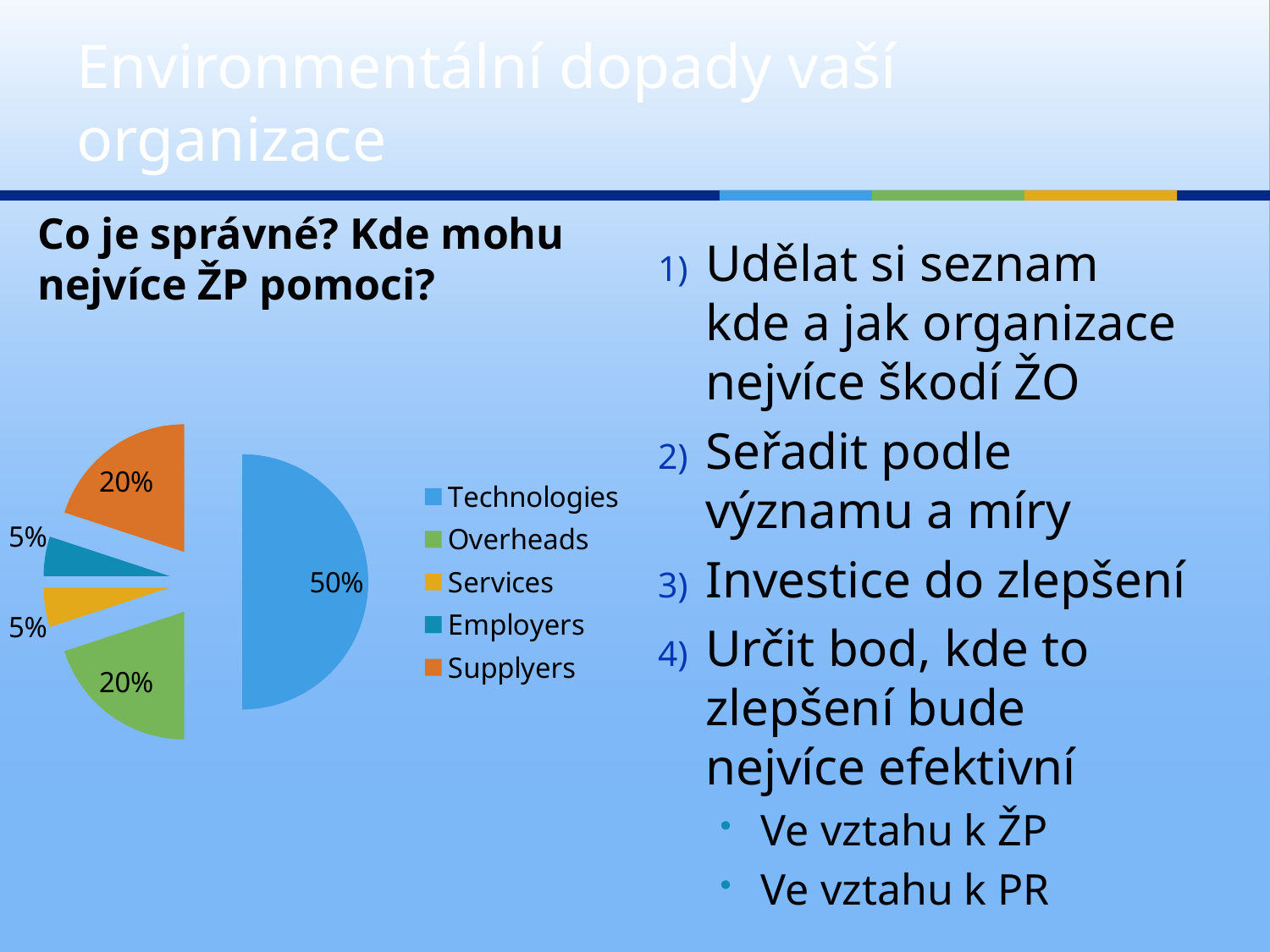
How many entries does the legend list? 5 What is the combined share of Services and Employers? 10% What share of the pie does Overheads have? 20% What share of the pie does Supplyers have? 20% What share of the pie does Technologies have? 50% What kind of chart is shown on the slide? pie chart Which category has the largest slice of the pie? Technologies Which is larger, the Supplyers slice or the Employers slice? Supplyers What is the difference between the Technologies share and the Overheads share? 30% Which colour represents Supplyers in the legend? orange How many slices does the pie chart have? 5 What share of the pie does Services have? 5%